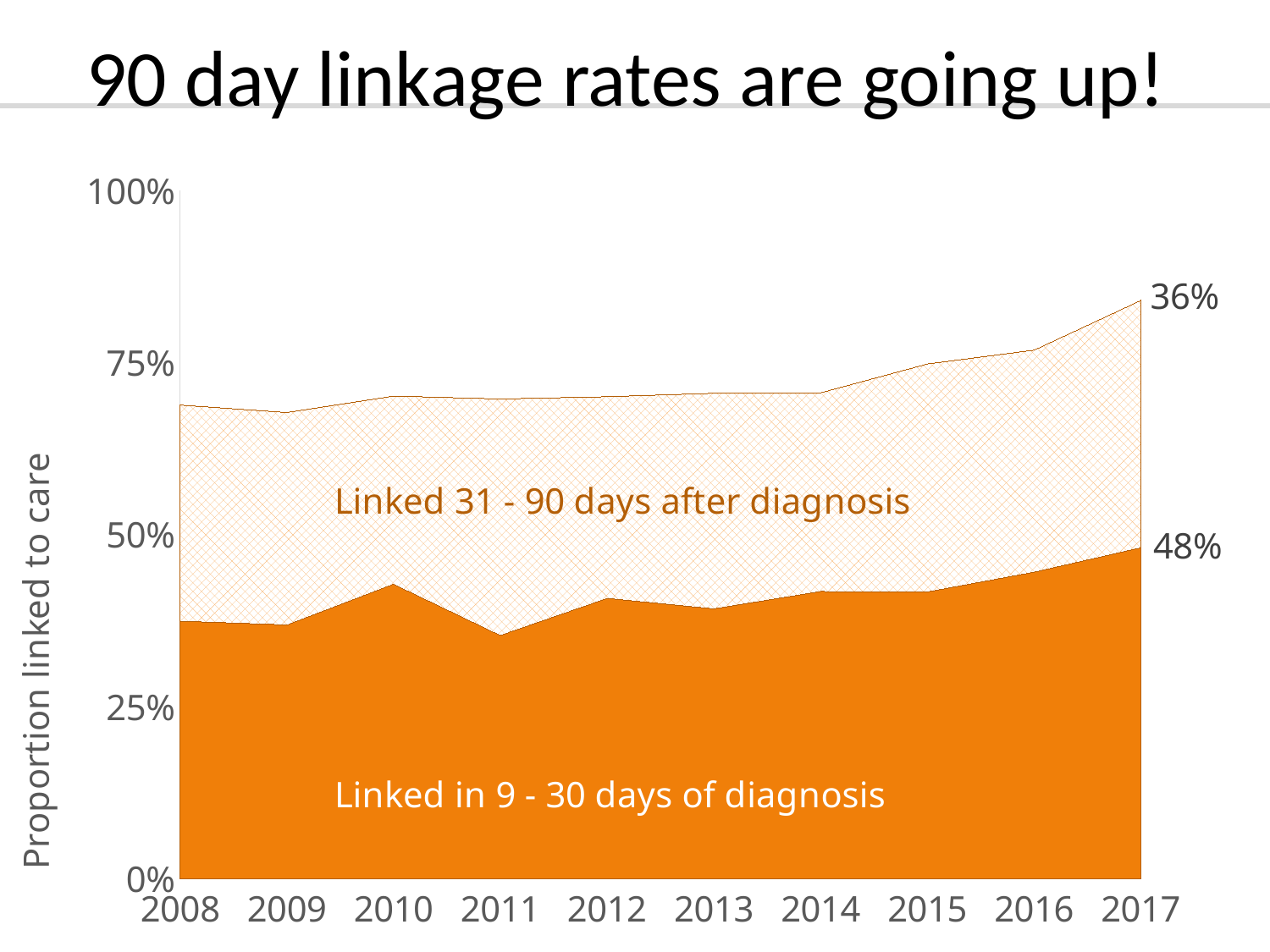
What kind of chart is shown on the slide? stacked area chart What proportion was linked in 9 - 30 days of diagnosis in 2017? 48% What proportion was linked 31 - 90 days after diagnosis in 2017? 36% Does the total proportion linked to care within 90 days rise or fall from 2014 to 2017? rise What is the label on the vertical axis? Proportion linked to care In 2017, which is larger: the proportion linked in 9 - 30 days or the proportion linked 31 - 90 days after diagnosis? Linked in 9 - 30 days of diagnosis What is the total proportion linked to care within 90 days in 2017? 84% Is the proportion linked in 9 - 30 days of diagnosis in 2008 greater or less than 50%? less How many years are shown along the x axis? 10 How many series are plotted in the chart? 2 In 2017, how much larger is the proportion linked in 9 - 30 days than the proportion linked 31 - 90 days after diagnosis? 12% What is the title of the chart on the slide? 90 day linkage rates are going up!